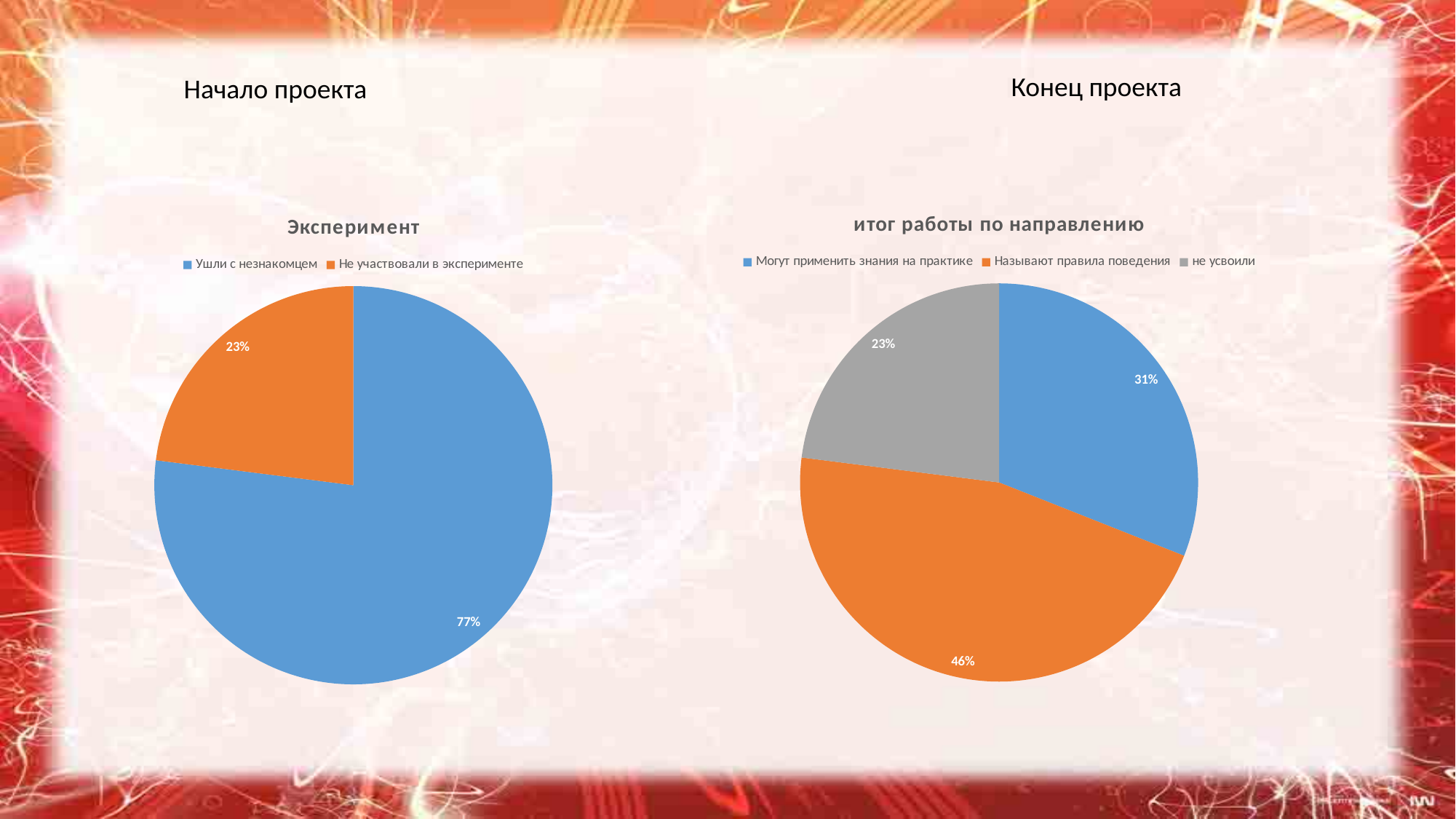
In the chart titled "итог работы по направлению", what share is labelled "Называют правила поведения"? 46% In the chart titled "Эксперимент", what is the difference between the two slices' percentages? 54% In the chart titled "итог работы по направлению", what share is labelled "не усвоили"? 23% In the chart titled "Эксперимент", what share of the pie is labelled "Ушли с незнакомцем"? 77% In the chart titled "итог работы по направлению", which is larger: "Могут применить знания на практике" or "Называют правила поведения"? Называют правила поведения In the chart titled "итог работы по направлению", which category has the smallest slice? не усвоили In the chart titled "Эксперимент", which category has the largest slice? Ушли с незнакомцем What type of chart is the chart titled "Эксперимент"? Pie chart In the chart titled "Эксперимент", how many slices does the pie have? 2 In the chart titled "итог работы по направлению", how many categories does the legend list? 3